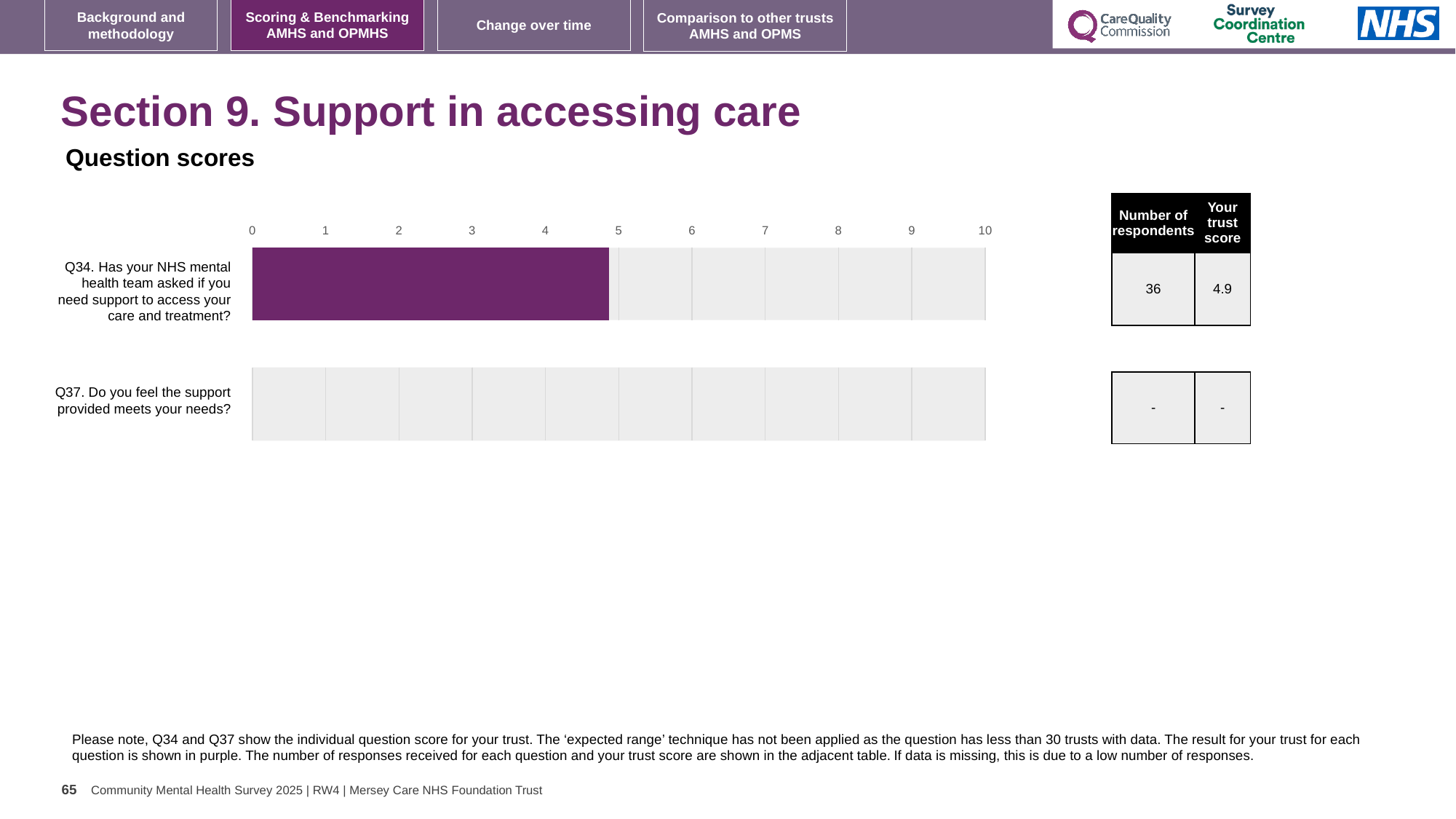
What is the number of respondents shown in the table for Q37? - What is the trust score shown in the table for Q37? - Is the bar for Q34 greater or less than 4 on the axis? greater What is the trust score for Q34 shown in the table? 4.9 Is the bar for Q34 greater or less than 5 on the axis? less How many respondents answered Q34 according to the table? 36 Which question has no score shown on the chart? Q37 How many questions are listed on the chart? 2 What is the highest value shown on the chart's axis? 10 What kind of chart is shown on the slide? bar chart